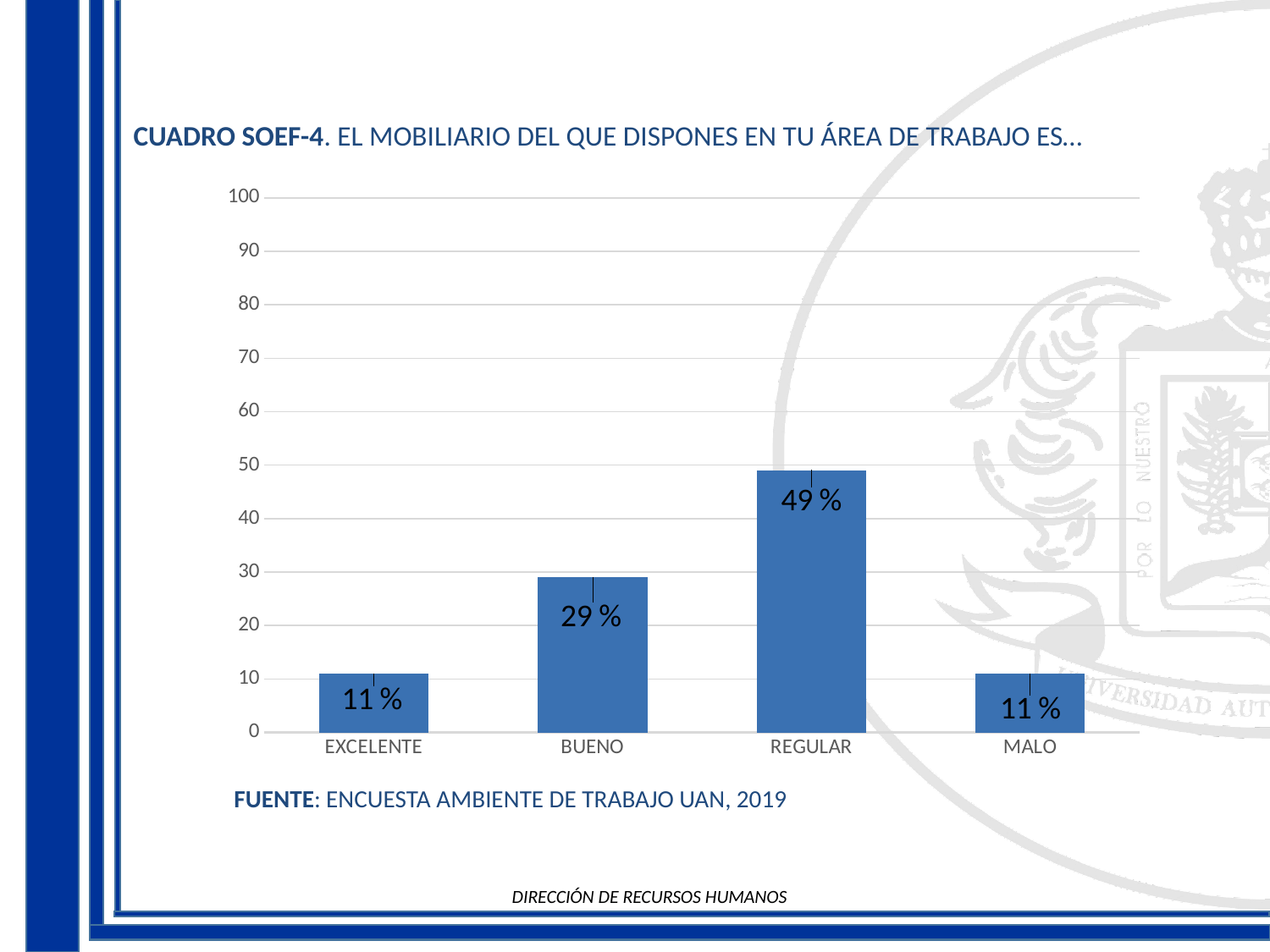
What is the value for REGULAR? 49 % What is the source cited below the chart? ENCUESTA AMBIENTE DE TRABAJO UAN, 2019 Which category has the highest value? REGULAR Which is larger, the value for BUENO or the value for EXCELENTE? BUENO Is the value for MALO greater or less than 20? less Is the value for REGULAR greater or less than 40? greater How many categories are shown on the x axis? 4 What is the value for BUENO? 29 % What is the value for EXCELENTE? 11 % What is the difference between the values for REGULAR and BUENO? 20 % What kind of chart is shown on the slide? bar chart What is the difference between the values for BUENO and MALO? 18 %